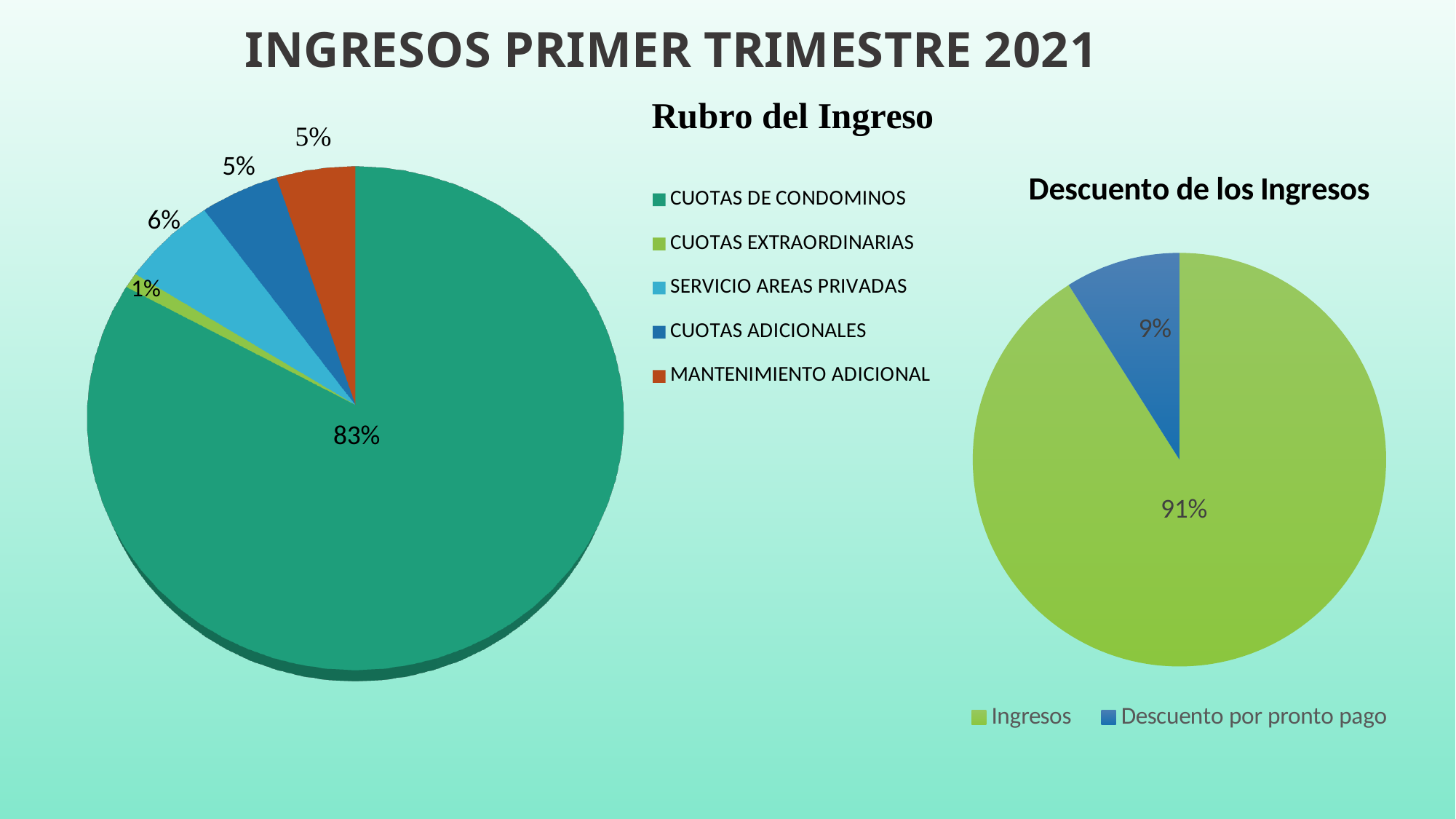
In the 'Rubro del Ingreso' chart, which category has the smallest share? CUOTAS EXTRAORDINARIAS In the 'Rubro del Ingreso' chart, which category has the largest share? CUOTAS DE CONDOMINOS In the 'Rubro del Ingreso' chart, what is the difference between the shares of CUOTAS DE CONDOMINOS and SERVICIO AREAS PRIVADAS? 77% In the 'Descuento de los Ingresos' chart, what share does 'Ingresos' have? 91% In the 'Descuento de los Ingresos' chart, what share does 'Descuento por pronto pago' have? 9% In the 'Rubro del Ingreso' chart, what share does CUOTAS EXTRAORDINARIAS have? 1% In the 'Rubro del Ingreso' chart, which is larger, SERVICIO AREAS PRIVADAS or CUOTAS ADICIONALES? SERVICIO AREAS PRIVADAS What type of chart is the 'Descuento de los Ingresos' chart? Pie chart In the 'Rubro del Ingreso' chart, how many categories does the legend list? 5